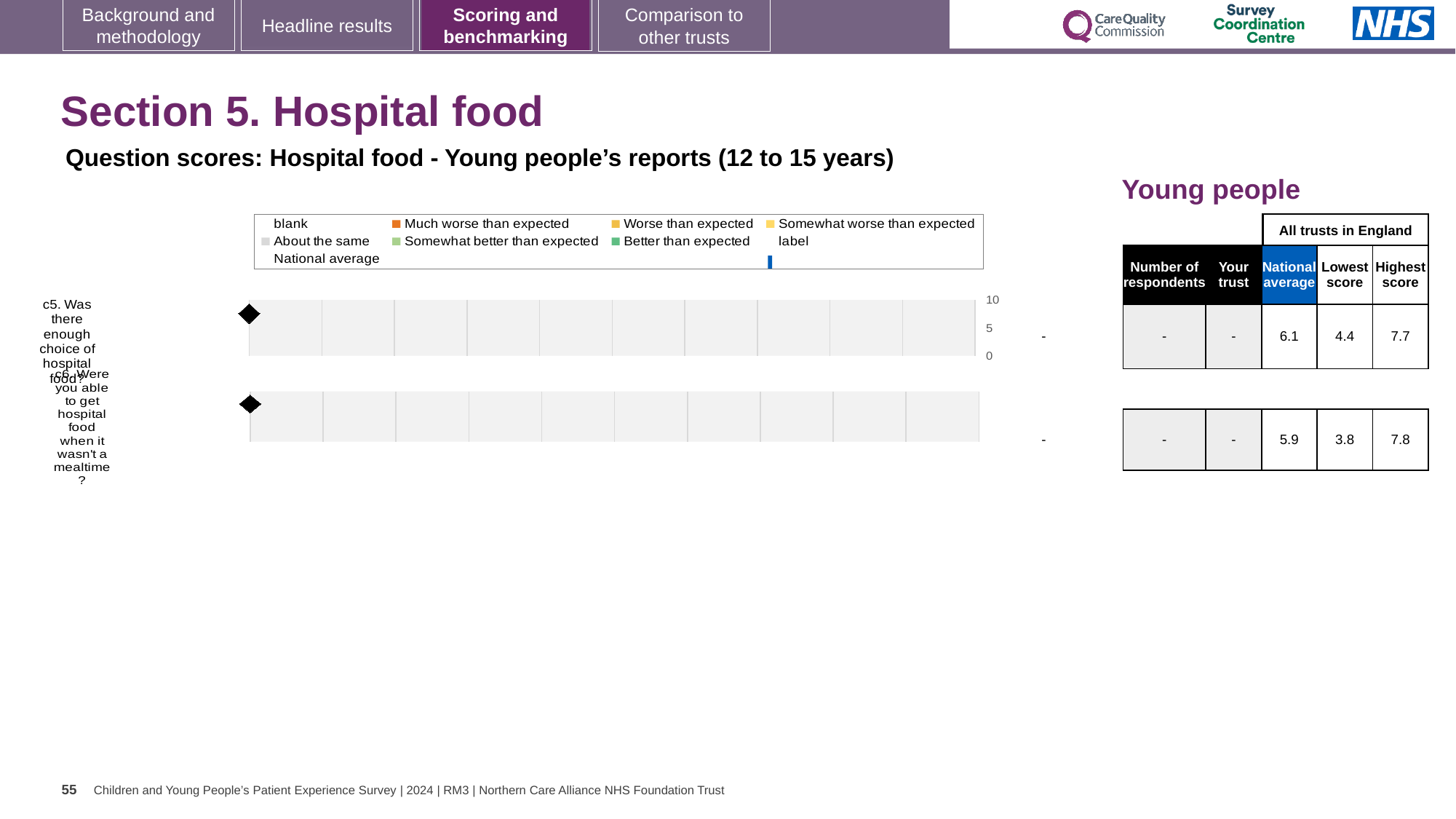
Which legend entry is shown with an orange marker? Much worse than expected In the table beside the chart, what is the difference between the highest and lowest scores for c6? 4.0 In the table beside the chart, what is the national average score for c6 (Were you able to get hospital food when it wasn't a mealtime?)? 5.9 In the table beside the chart, what is the national average score for c5 (Was there enough choice of hospital food?)? 6.1 How many question categories are listed on the chart's vertical axis? 2 In the table beside the chart, what is the highest score across all trusts in England for c6? 7.8 In the table beside the chart, what value is shown for 'Your trust' for c5? - In the table beside the chart, what is the difference between the highest and lowest scores for c5? 3.3 In the table beside the chart, which question has the higher national average, c5 or c6? c5 In the table beside the chart, what is the lowest score across all trusts in England for c5? 4.4 What kind of chart is shown on the slide? bar chart What is the highest tick value shown on the chart's value axis? 10